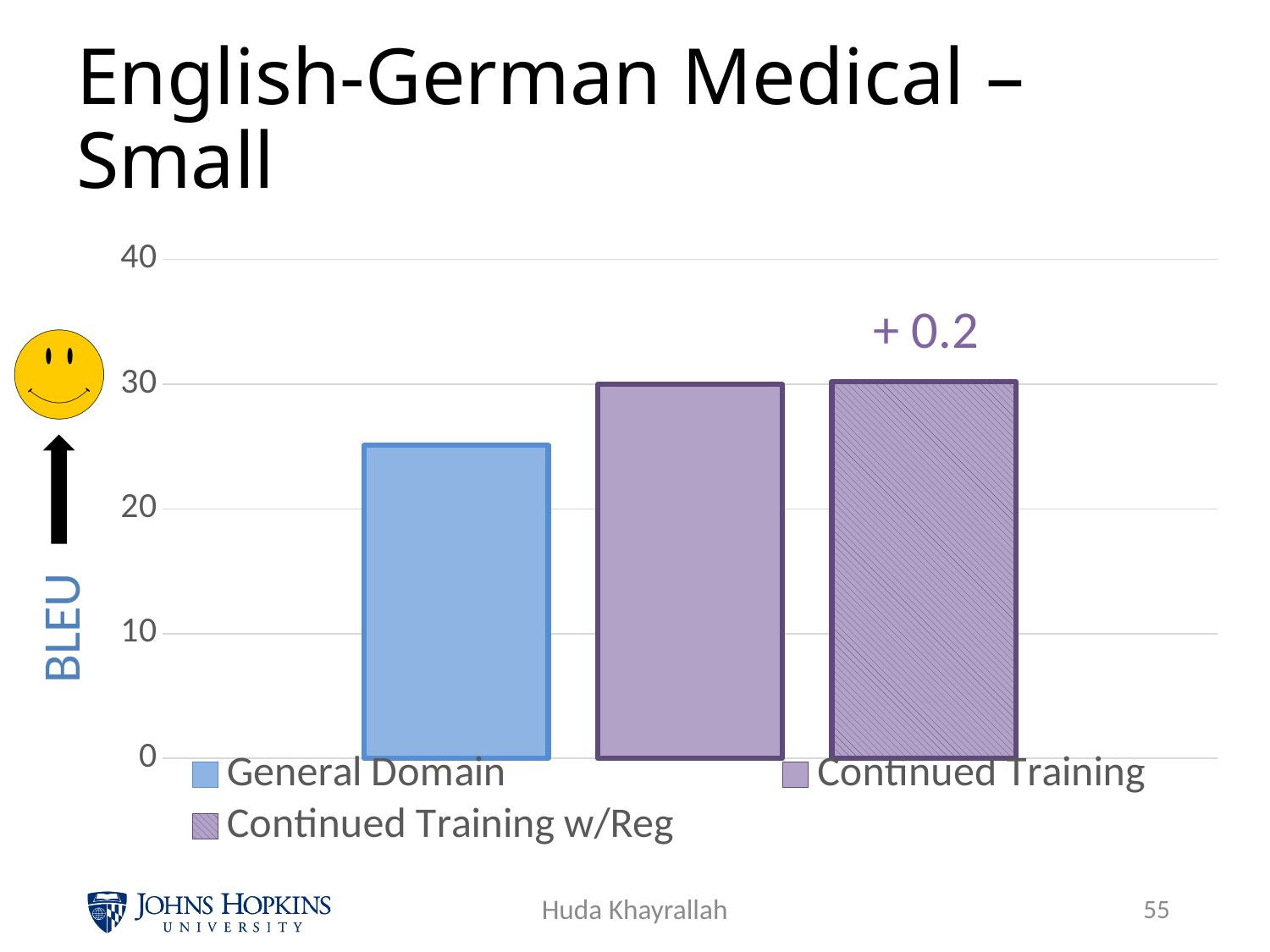
Is the BLEU value for General Domain greater or less than 20? greater Which series has the lowest BLEU score? General Domain Is the BLEU value for Continued Training w/Reg greater or less than 40? less What is the label on the y axis of the chart? BLEU How many series does the legend list? 3 According to the annotation above the bar, by how much does Continued Training w/Reg improve over Continued Training? + 0.2 What is the title of the slide containing the chart? English-German Medical – Small Is the BLEU value for Continued Training greater or less than 20? greater Which is larger, the BLEU score for General Domain or for Continued Training? Continued Training How many bars are plotted in the chart? 3 What kind of chart is shown on the slide? bar chart